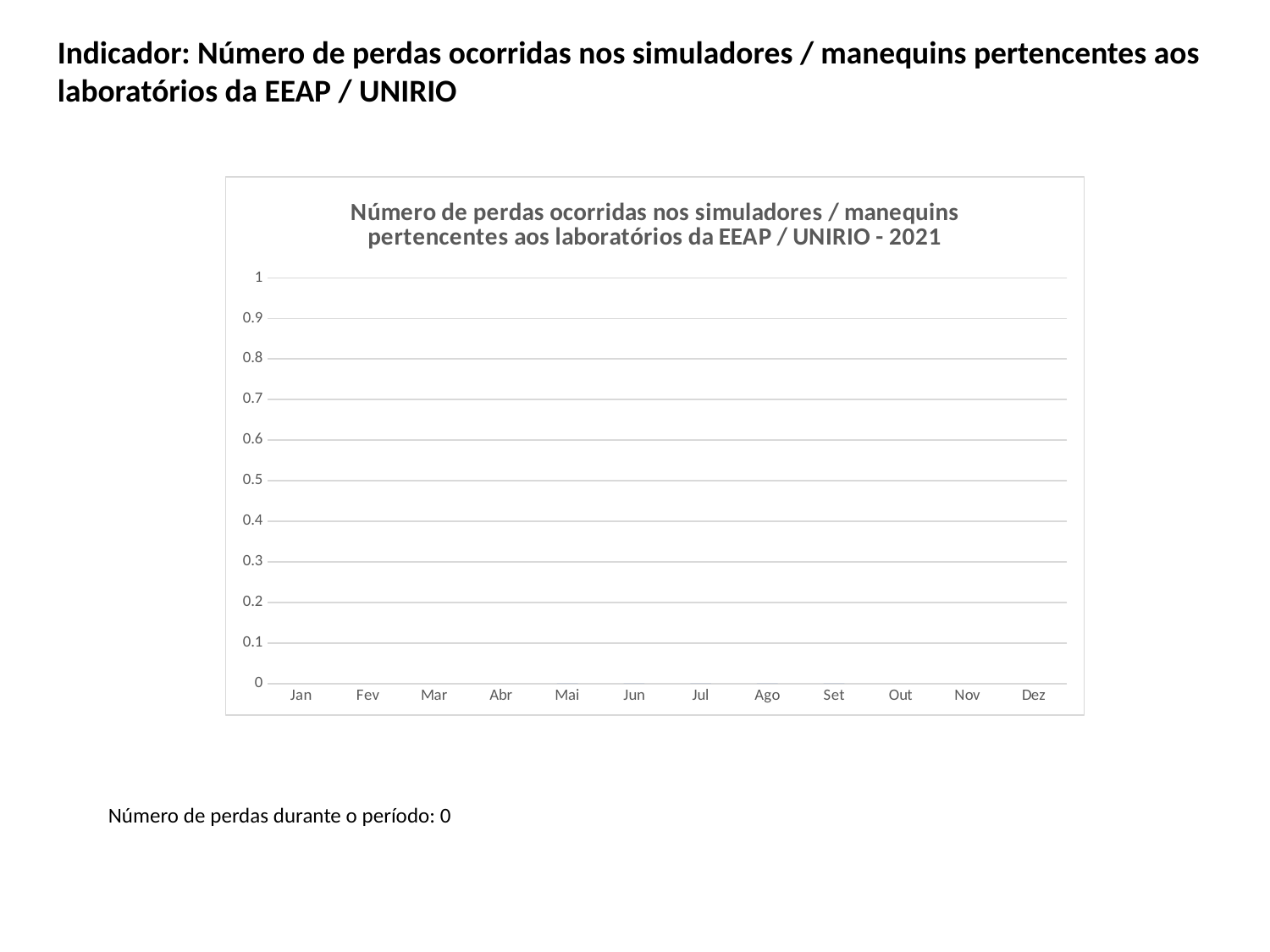
What is the highest value shown on the chart's y axis? 1 How many categories are shown on the x axis of the chart? 12 What is the last category label on the x axis of the chart? Dez What is the title of the chart? Número de perdas ocorridas nos simuladores / manequins pertencentes aos laboratórios da EEAP / UNIRIO - 2021 According to the text below the chart, what is the number of losses during the period? 0 What is the first category label on the x axis of the chart? Jan